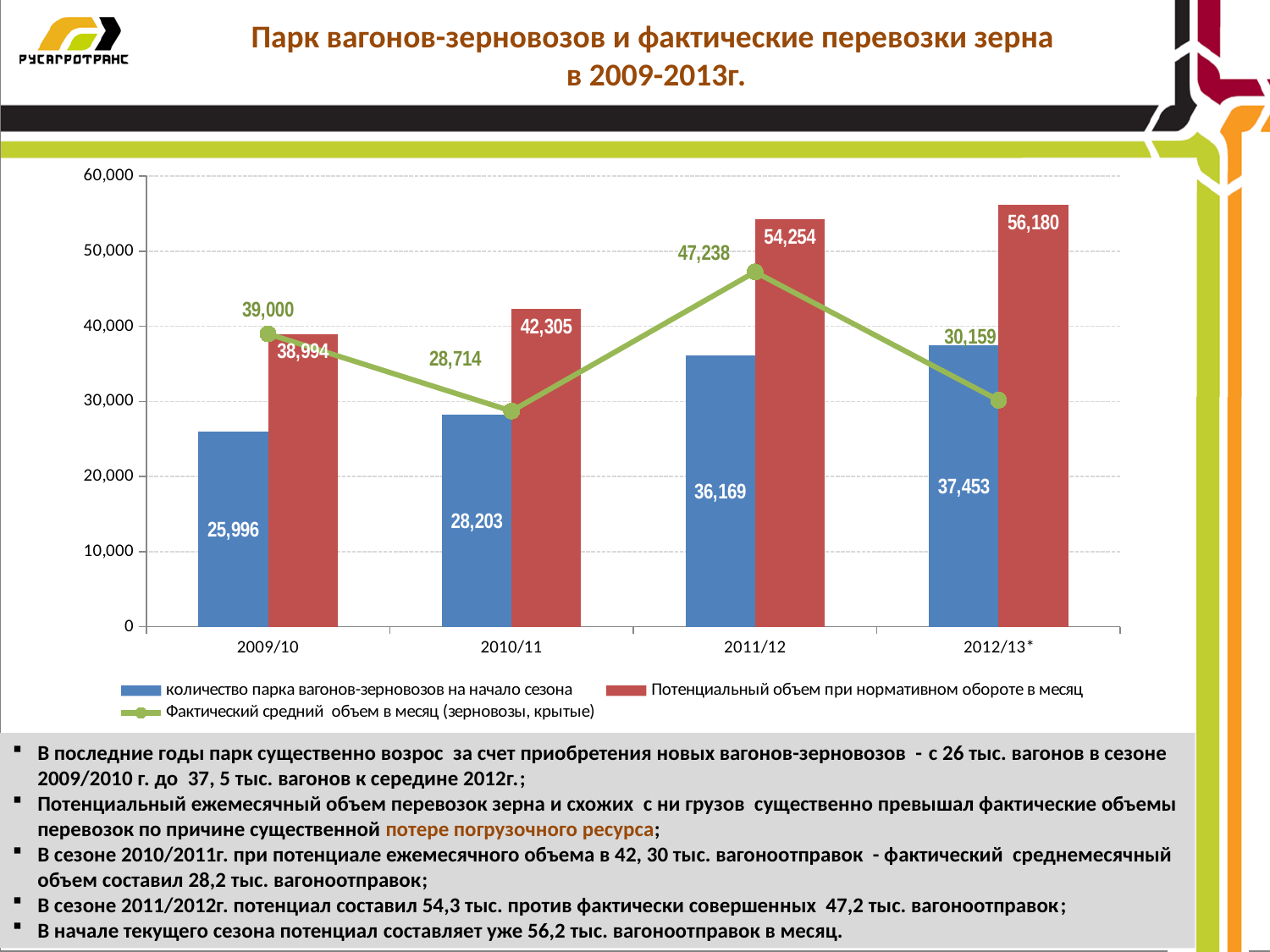
What is the value of the red series (Потенциальный объем при нормативном обороте в месяц) for 2011/12? 54,254 What is the difference between the red bar and the green line value for 2012/13*? 26,021 How many seasons are shown on the x axis? 4 What is the value of the green line (Фактический средний объем в месяц) for 2010/11? 28,714 How many series does the legend list? 3 Which season has the highest value for the red series (Потенциальный объем при нормативном обороте в месяц)? 2012/13* Do the values of the blue series (количество парка вагонов-зерновозов) rise or fall from 2009/10 to 2012/13*? rise Which season has the lowest value for the green line (Фактический средний объем в месяц)? 2010/11 Which is larger for 2009/10: the red bar (Потенциальный объем) or the green line (Фактический средний объем)? Фактический средний объем (39,000) What kind of chart is shown on the slide? Combined bar and line chart Is the blue bar for 2011/12 greater or less than 30,000? greater What is the value of the blue series (количество парка вагонов-зерновозов на начало сезона) for 2009/10? 25,996